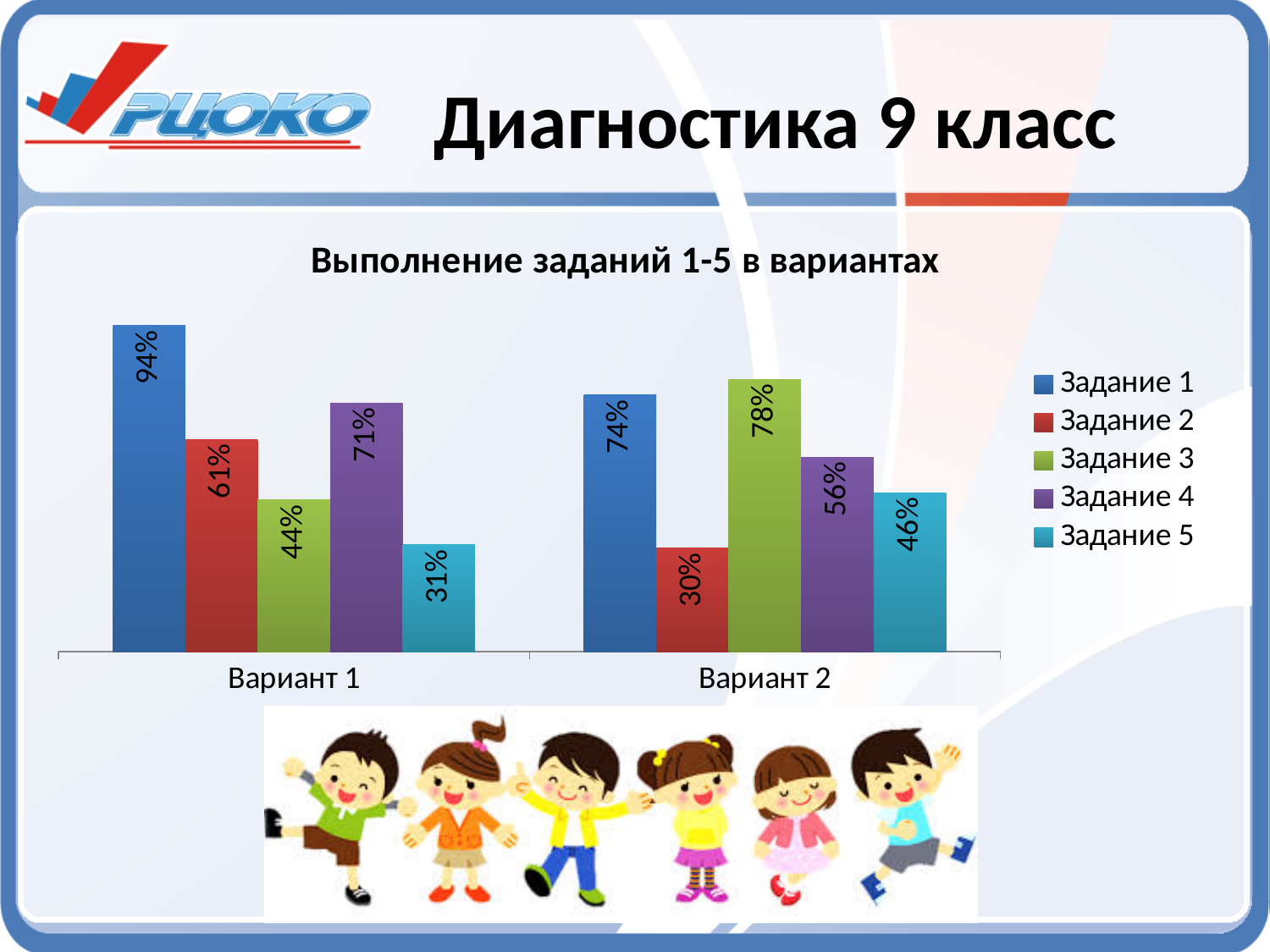
Which task has the highest value in Вариант 1? Задание 1 What is the difference between Задание 4 and Задание 5 in Вариант 2? 10% What is the difference between Задание 1 in Вариант 1 and Задание 1 in Вариант 2? 20% What is the value for Задание 5 in Вариант 1? 31% How many categories are shown on the x axis? 2 How many series does the legend list? 5 What is the value for Задание 1 in Вариант 1? 94% What kind of chart is shown on the slide? Bar chart Which is larger: Задание 3 in Вариант 1 or Задание 3 in Вариант 2? Задание 3 in Вариант 2 What is the value for Задание 2 in Вариант 2? 30% What is the value for Задание 3 in Вариант 2? 78% Which task has the lowest value in Вариант 2? Задание 2